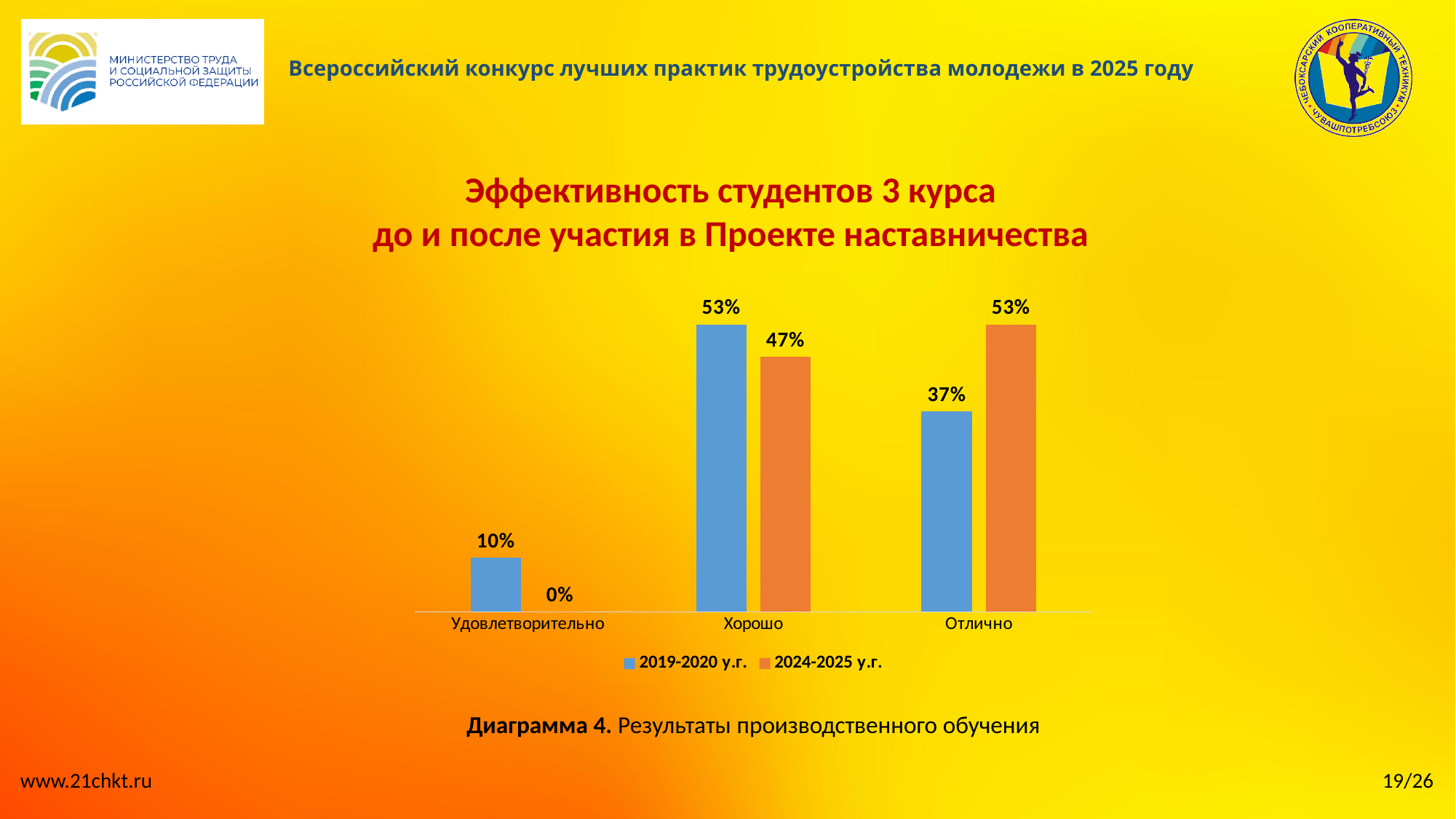
What kind of chart is shown on the slide? Bar chart Which category has the highest value in the 2019-2020 у.г. series? Хорошо How many categories are shown on the x axis? 3 For Хорошо, which series has the larger value: 2019-2020 у.г. or 2024-2025 у.г.? 2019-2020 у.г. What is the difference between the 2024-2025 у.г. and 2019-2020 у.г. values for Отлично? 16% What is the value for Отлично in the 2019-2020 у.г. series? 37% What is the value for Хорошо in the 2024-2025 у.г. series? 47% How many series does the legend list? 2 What is the value for Удовлетворительно in the 2024-2025 у.г. series? 0% Which category has the lowest value in the 2024-2025 у.г. series? Удовлетворительно Which colour represents the 2024-2025 у.г. series? Orange What is the value for Удовлетворительно in the 2019-2020 у.г. series? 10%